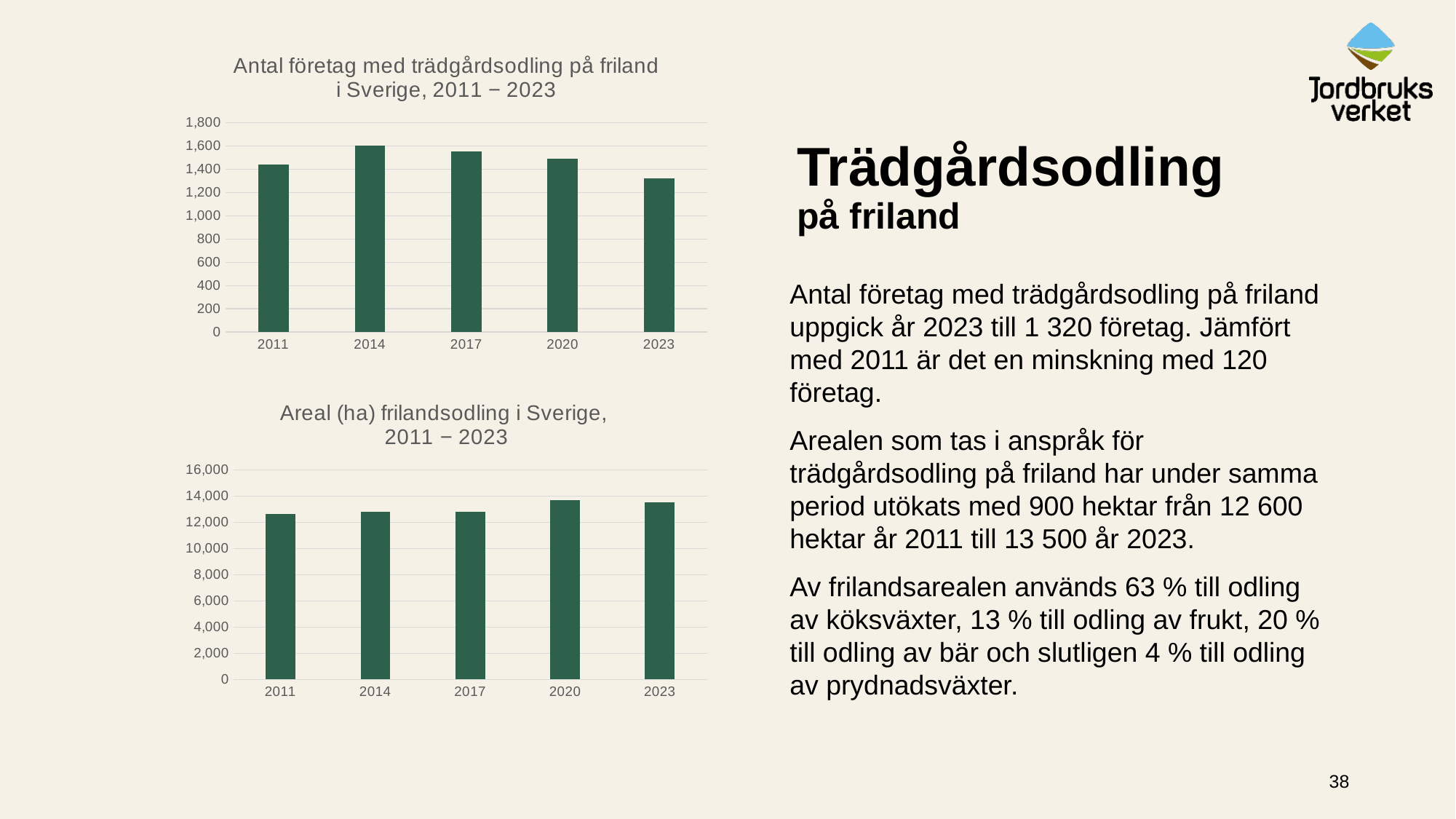
In the bottom chart, do the values generally rise or fall from 2011 to 2023? rise How many years are shown in the top chart? 5 In the top chart, is the value for 2017 greater or less than 1,400? greater In the bottom chart, is the value for 2011 greater or less than 14,000? less In the bottom chart, which is larger, the value for 2011 or the value for 2020? 2020 What kind of chart is the top chart? bar chart In the top chart, is the value for 2023 greater or less than 1,400? less In the top chart, which year has the lowest number of companies? 2023 What is the title of the bottom chart? Areal (ha) frilandsodling i Sverige, 2011 – 2023 In the top chart, which year has the highest number of companies? 2014 In the top chart, which is larger, the value for 2014 or the value for 2023? 2014